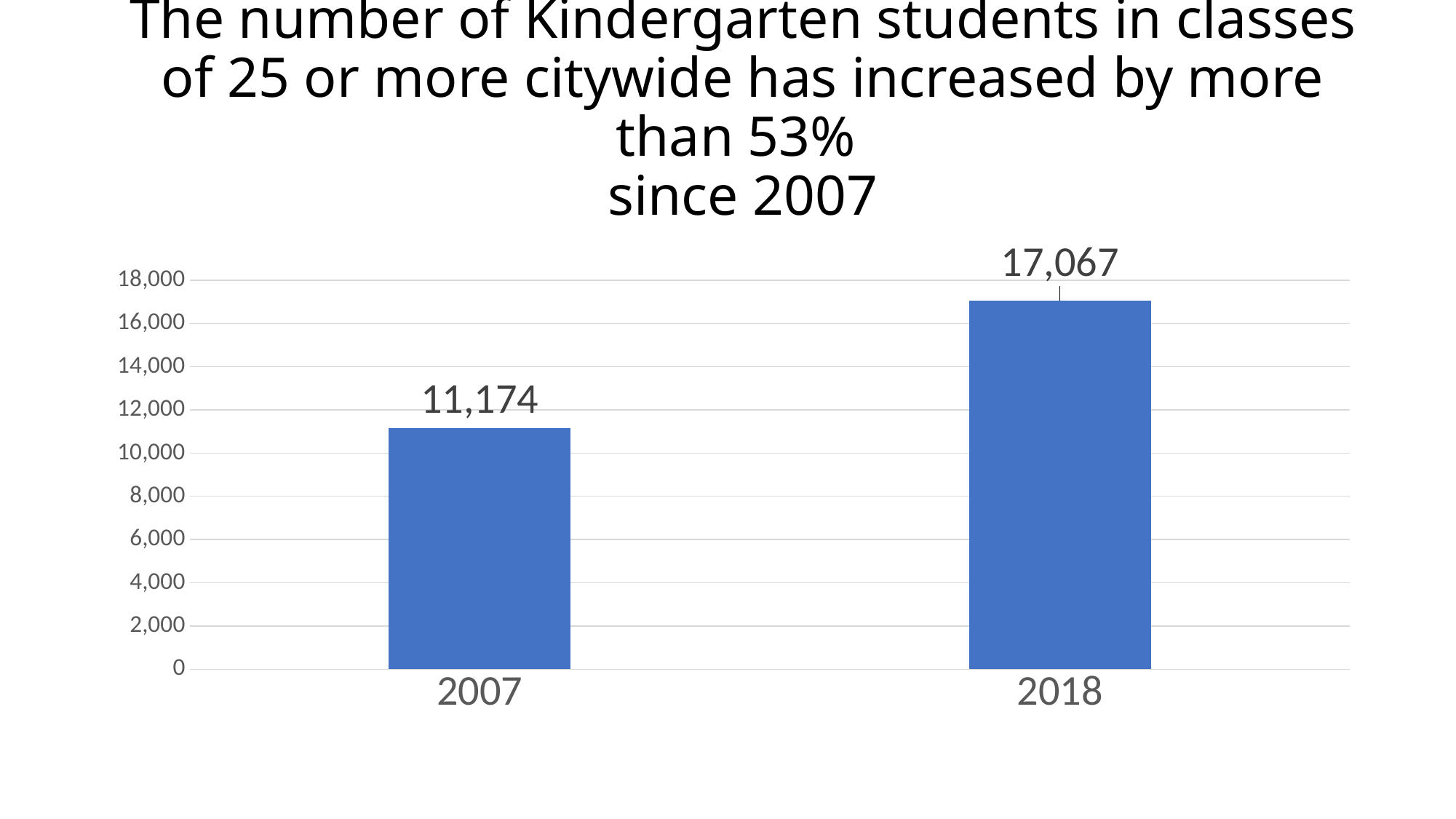
Is the value for 2018 larger than the value for 2007? Yes Which year has the lower value? 2007 Do the values rise or fall from 2007 to 2018? Rise What kind of chart is shown on the slide? Bar chart What is the difference between the 2018 value and the 2007 value? 5,893 What is the highest value labelled on the vertical axis? 18,000 Is the value for 2007 greater or less than 12,000? less How many bars are shown in the chart? 2 Is the value for 2018 greater or less than 16,000? greater What is the value shown for 2007? 11,174 What is the value shown for 2018? 17,067 Which year has the higher value? 2018